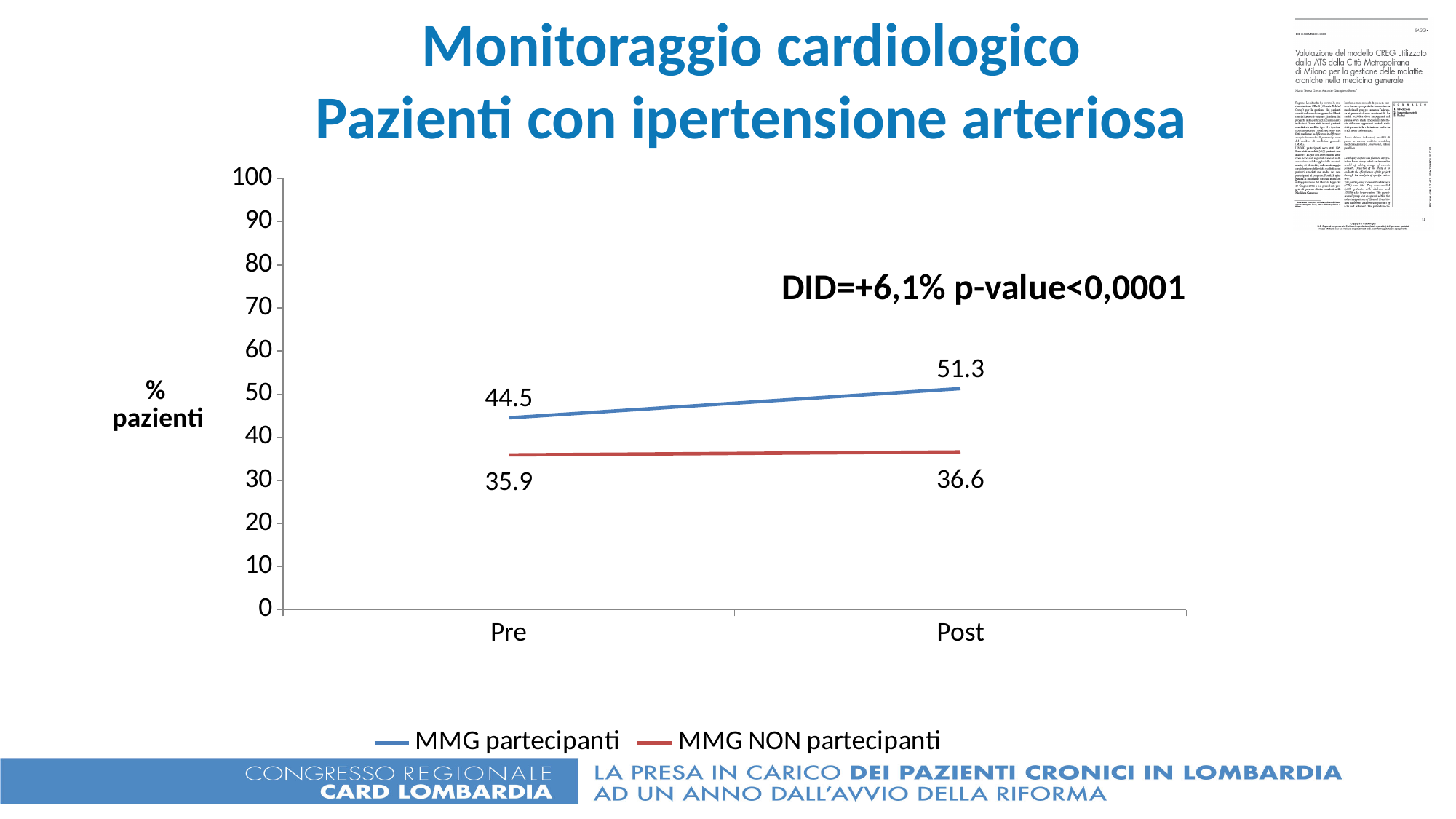
What is the value for MMG partecipanti at Pre? 44.5 What is the value for MMG partecipanti at Post? 51.3 Does the MMG partecipanti line rise or fall from Pre to Post? rise What is the difference between the Post and Pre values for MMG partecipanti? 6.8 What kind of chart is shown on the slide? line chart Which series has the higher value at Pre, MMG partecipanti or MMG NON partecipanti? MMG partecipanti How many series does the legend list? 2 How many categories are shown on the x axis? 2 What is the value for MMG NON partecipanti at Post? 36.6 What is the difference between MMG partecipanti and MMG NON partecipanti at Post? 14.7 What colour is the line for MMG NON partecipanti? red What is the value for MMG NON partecipanti at Pre? 35.9